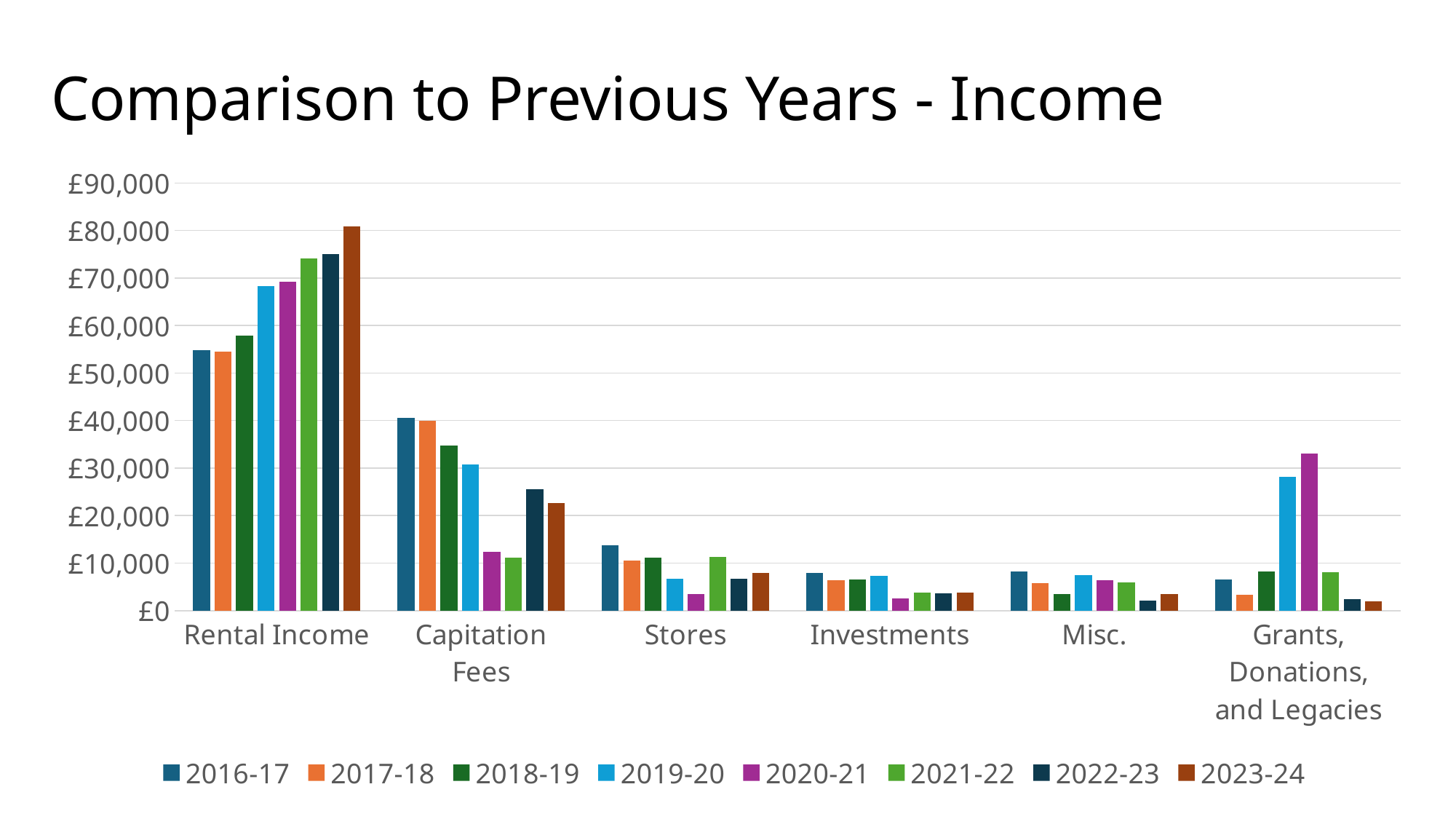
Which year has the highest value for Grants, Donations, and Legacies? 2020-21 How many series does the legend list? 8 How many income categories are shown on the x axis? 6 Which year has the highest Rental Income? 2023-24 Is the Capitation Fees value for 2020-21 greater or less than £20,000? less What is the title of the chart? Comparison to Previous Years - Income What kind of chart is shown on the slide? bar chart Which category has the highest value for 2023-24? Rental Income Which is larger for Capitation Fees: the 2016-17 value or the 2022-23 value? 2016-17 Is the Grants, Donations, and Legacies value for 2019-20 greater or less than £20,000? greater Is the Rental Income value for 2023-24 greater or less than £70,000? greater Does Rental Income generally rise or fall from 2016-17 to 2023-24? rise